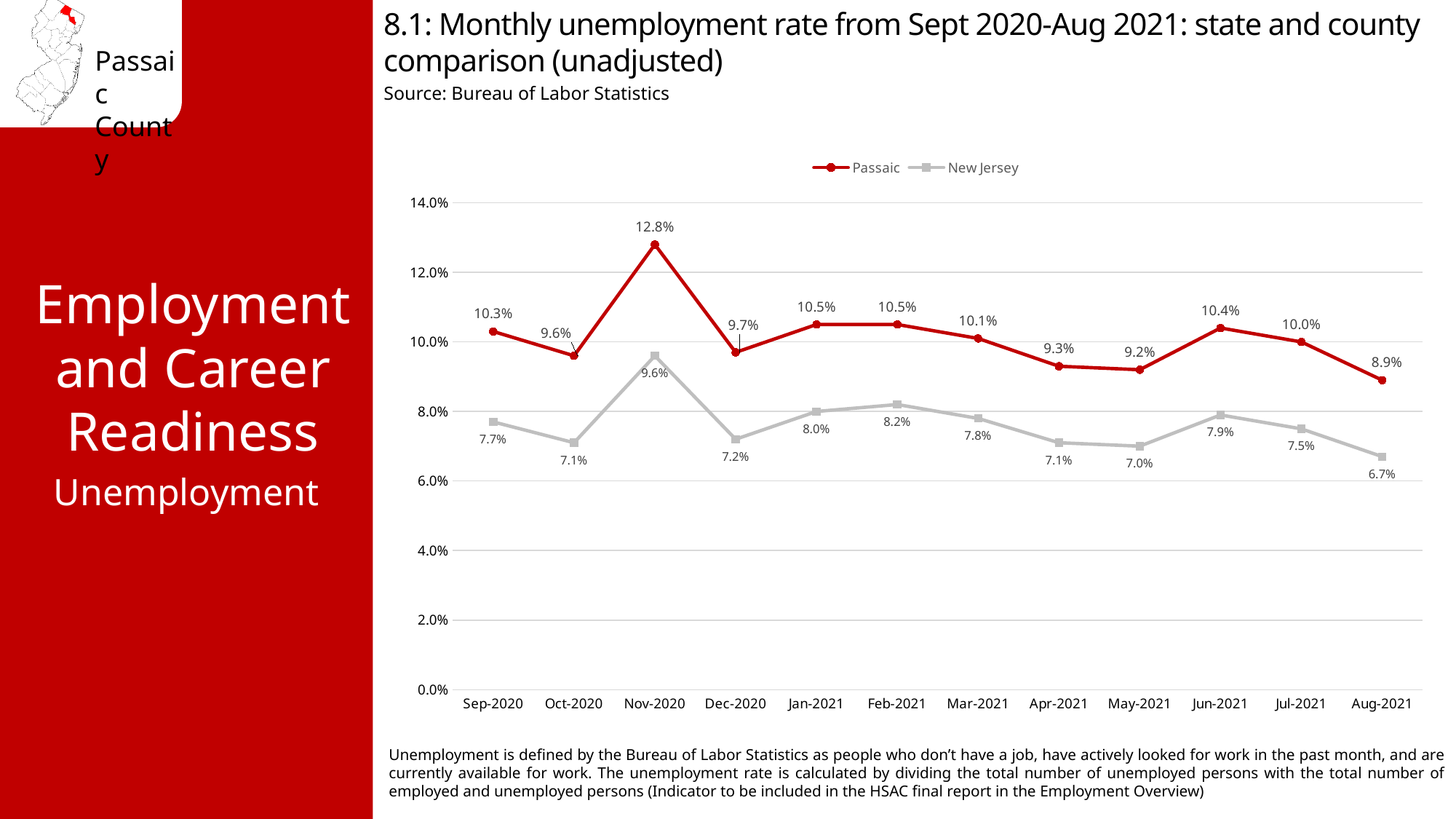
In which month was the New Jersey unemployment rate lowest? Aug-2021 What kind of chart is shown on the slide? Line chart How many series does the legend list? 2 What is the source cited for the chart data? Bureau of Labor Statistics What was the Passaic unemployment rate in Nov-2020? 12.8% What is the difference between the Passaic and New Jersey unemployment rates in Nov-2020? 3.2% In which month was the Passaic unemployment rate highest? Nov-2020 How many months are plotted on the x axis? 12 What was the New Jersey unemployment rate in Aug-2021? 6.7% What was the New Jersey unemployment rate in Feb-2021? 8.2% Did the Passaic unemployment rate rise or fall from Jun-2021 to Aug-2021? Fall Which series had the higher unemployment rate in Jun-2021, Passaic or New Jersey? Passaic